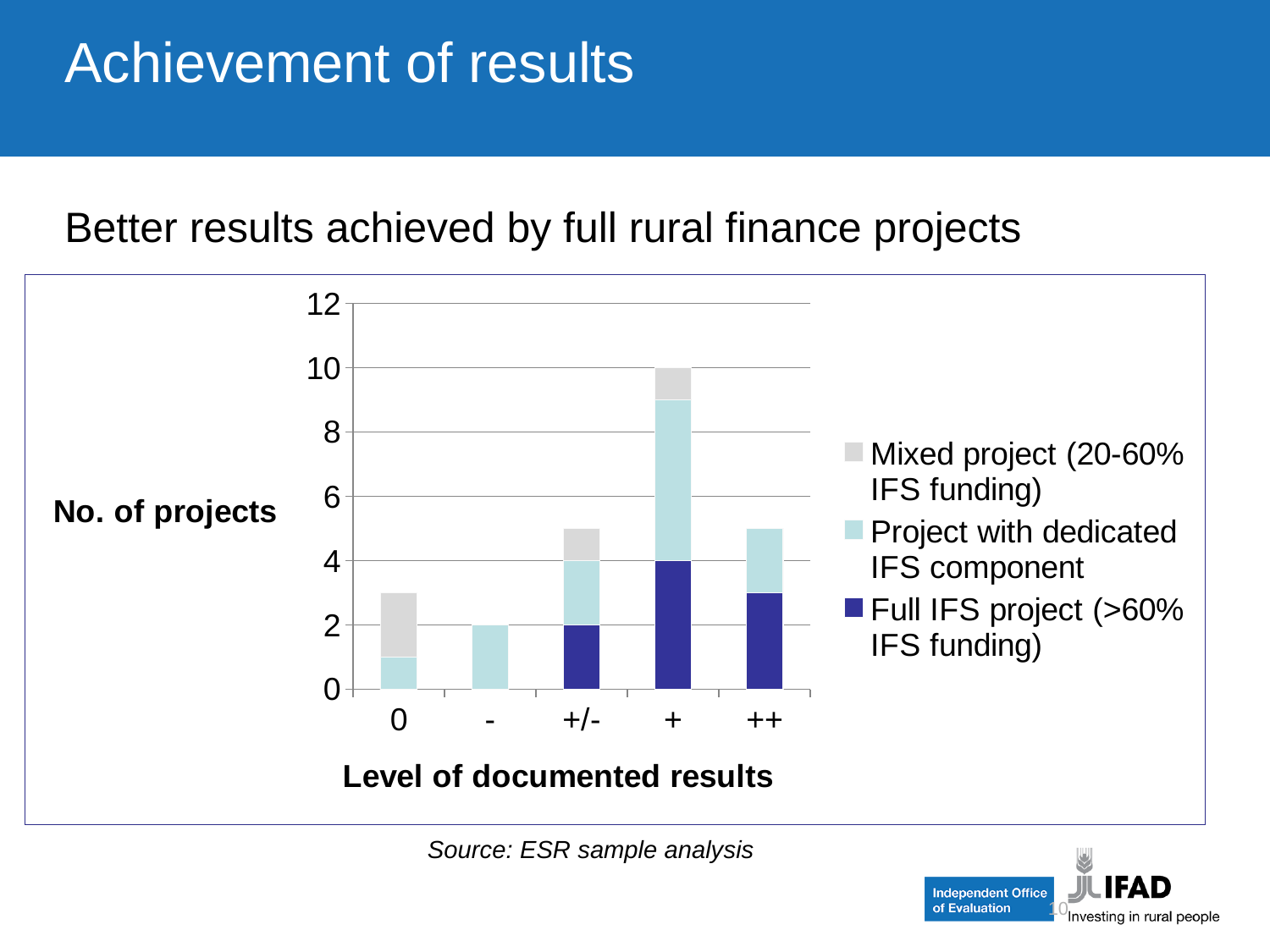
Which has a larger total number of projects, the '+' level or the '++' level? + Is the total number of projects for the '++' level greater or less than 4? greater What kind of chart is shown on the slide? Stacked bar chart What is the label of the y axis? No. of projects Is the total number of projects for the '0' level greater or less than 4? less How many categories are shown on the x axis (Level of documented results)? 5 Which level of documented results has the lowest total number of projects? - How many Full IFS projects (>60% IFS funding) are at the '+' level of documented results? 4 Which level of documented results has the highest total number of projects? + What is the total number of projects for the '-' level of documented results? 2 What is the total number of projects for the '+' level of documented results? 10 How many series does the legend list? 3